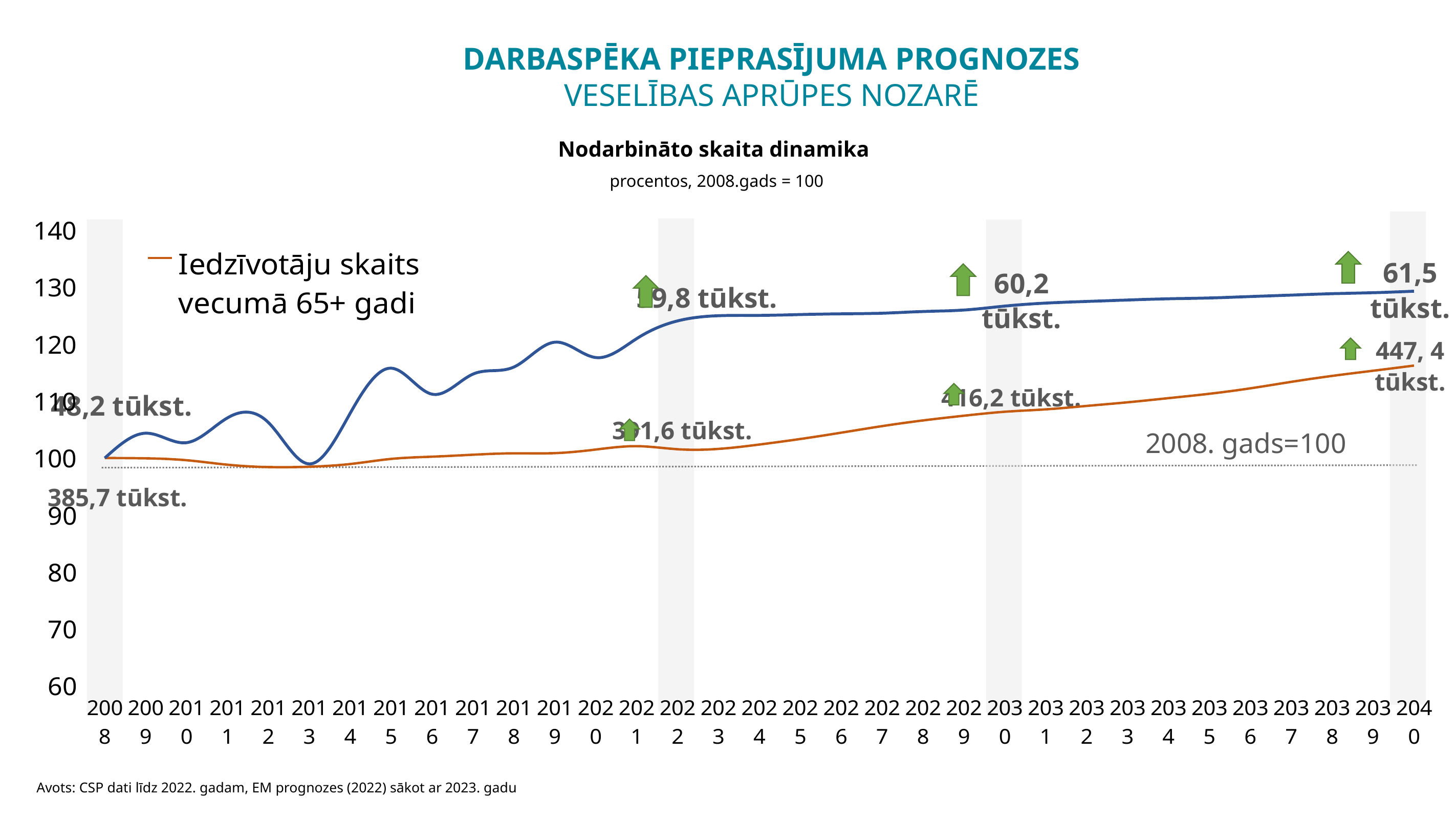
What kind of chart is shown on the slide? line chart In 2040, which line is higher, the blue line or the orange line? the blue line Does the orange line (Iedzīvotāju skaits vecumā 65+ gadi) generally rise or fall from 2013 to 2040? rise How many series does the chart legend list? 1 Is the value of the blue line in 2040 greater or less than 120? greater What is the legend entry shown on the chart? Iedzīvotāju skaits vecumā 65+ gadi Is the value of the orange line (Iedzīvotāju skaits vecumā 65+ gadi) in 2040 greater or less than 110? greater What absolute value is annotated for the orange line at the end of the chart in 2040? 447,4 tūkst. Is the value of the blue line in 2013 greater or less than 110? less What is the title of the chart? Nodarbināto skaita dinamika In which year does the blue line reach its highest value? 2040 How many years are shown on the x axis of the chart? 33